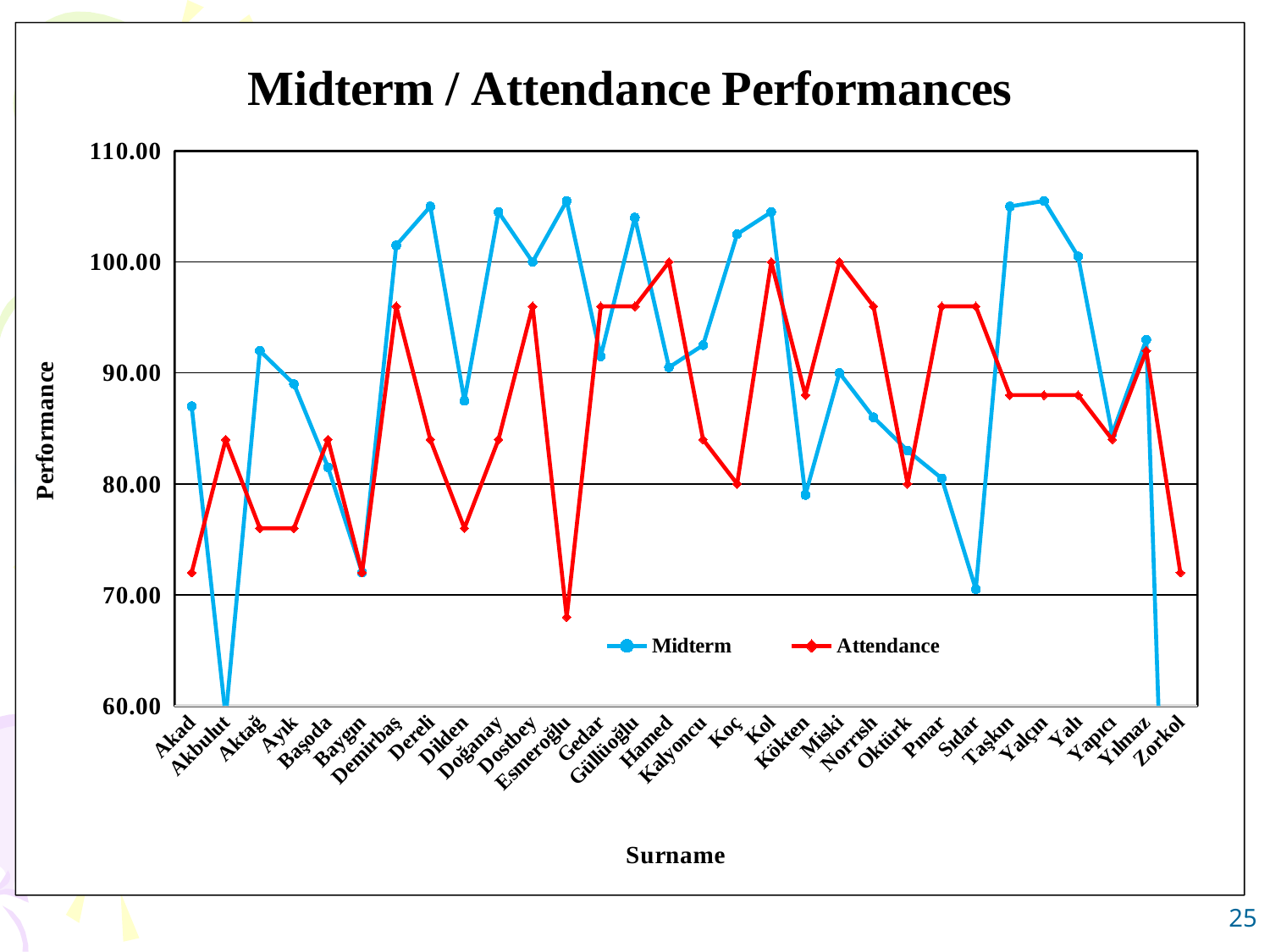
Which surname has the lowest Attendance value? Esmeroğlu Is the Attendance value for Akad greater or less than 80? less What is the title of the chart? Midterm / Attendance Performances How many surnames are plotted along the x axis? 30 For Esmeroğlu, which is larger: the Midterm value or the Attendance value? Midterm How many series does the legend list? 2 What is the Attendance value for Koç? 80.00 What kind of chart is shown on the slide? Line chart What is the Attendance value for Hamed? 100.00 Is the Midterm value for Sıdar greater or less than 80? less Is the Midterm value for Dereli greater or less than 100? greater What is the Midterm value for Dostbey? 100.00